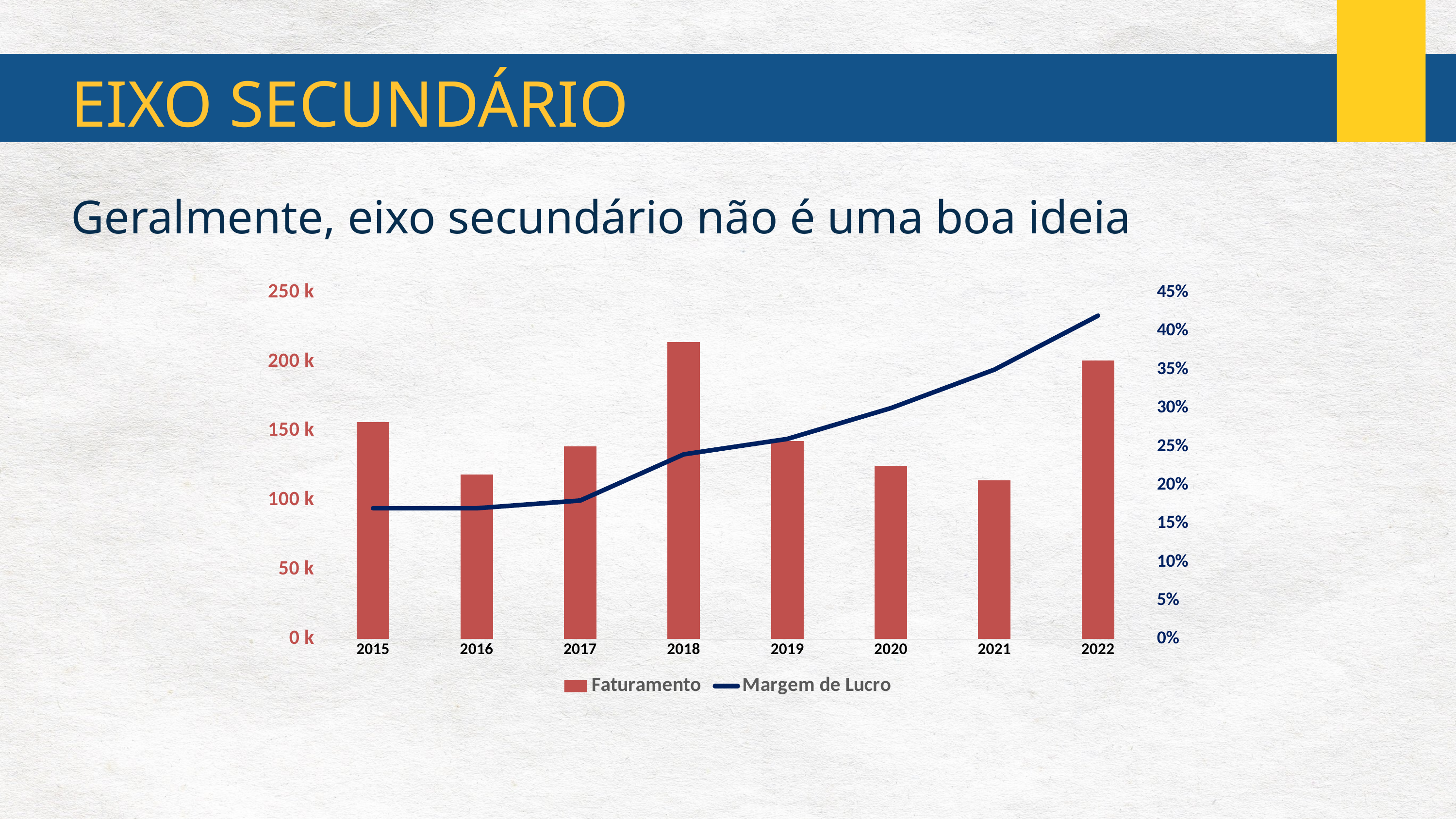
Is the Faturamento value for 2021 greater or less than 150 k? less Is the Margem de Lucro value for 2022 greater or less than 40%? greater Which series is drawn as bars in the chart? Faturamento Does the Margem de Lucro line rise or fall from 2015 to 2022? rises Is the Margem de Lucro value for 2015 greater or less than 20%? less How many series does the chart legend list? 2 How many years are shown on the x axis of the chart? 8 Which series is drawn as a line in the chart? Margem de Lucro Which year has the larger Faturamento bar, 2018 or 2022? 2018 In which year is the Faturamento bar the highest? 2018